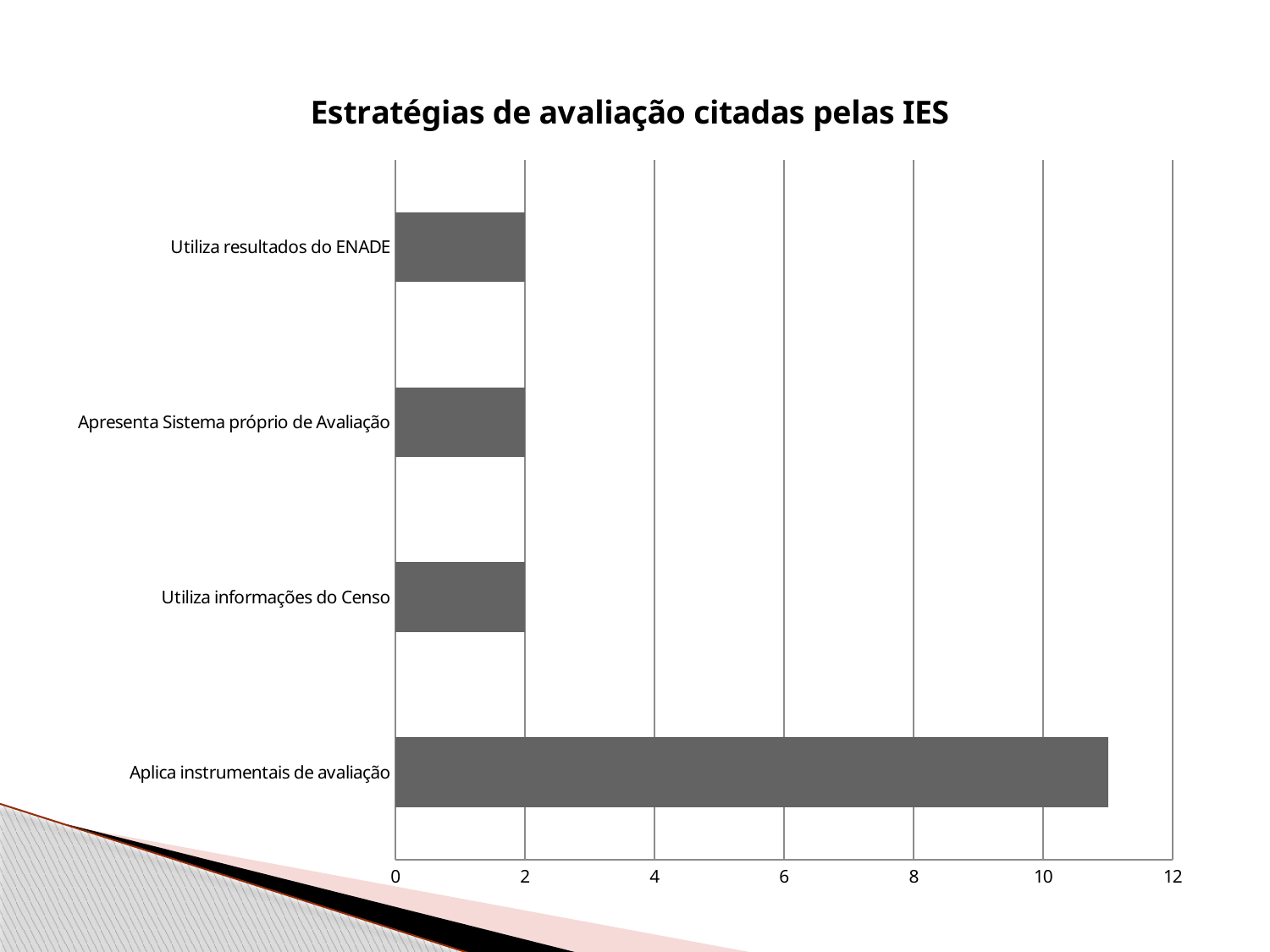
How many categories are shown in the chart? 4 What kind of chart is shown on the slide? bar chart Which is larger, the value for Aplica instrumentais de avaliação or the value for Utiliza informações do Censo? Aplica instrumentais de avaliação Which category has the highest value? Aplica instrumentais de avaliação Is the value for Aplica instrumentais de avaliação greater or less than 12? less What is the value for Utiliza resultados do ENADE? 2 What is the maximum value shown on the horizontal axis? 12 What is the value for Apresenta Sistema próprio de Avaliação? 2 Is the value for Aplica instrumentais de avaliação greater or less than 10? greater What is the title of the chart? Estratégias de avaliação citadas pelas IES What is the value for Utiliza informações do Censo? 2